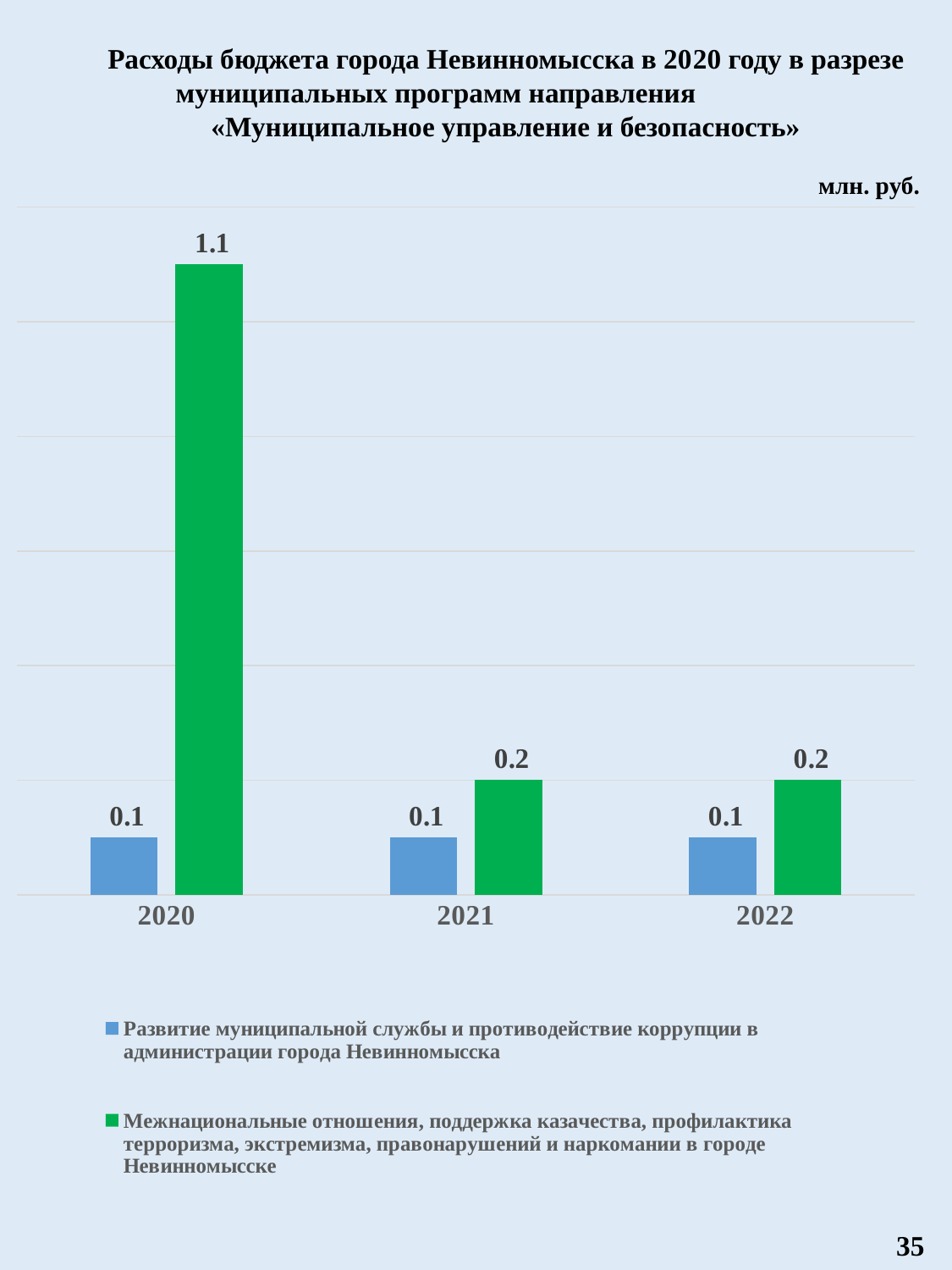
What kind of chart is shown on the slide? Bar chart Does the value for the series «Межнациональные отношения, поддержка казачества...» rise or fall from 2020 to 2021? Fall How many years are shown on the x axis of the chart? 3 What is the value for 2021 for the series «Развитие муниципальной службы и противодействие коррупции в администрации города Невинномысска»? 0.1 What is the value for 2022 for the series «Межнациональные отношения, поддержка казачества, профилактика терроризма, экстремизма, правонарушений и наркомании в городе Невинномысске»? 0.2 What is the difference between the two series' values in 2020? 1.0 What is the difference between the 2020 and 2021 values for the series «Межнациональные отношения, поддержка казачества...»? 0.9 What is the value for 2020 for the series «Межнациональные отношения, поддержка казачества, профилактика терроризма, экстремизма, правонарушений и наркомании в городе Невинномысске»? 1.1 In which year is the value for the series «Межнациональные отношения, поддержка казачества...» the highest? 2020 What unit of measurement is indicated for the chart values? млн. руб. How many series does the legend list? 2 In 2021, which series has the larger value: «Развитие муниципальной службы и противодействие коррупции...» or «Межнациональные отношения, поддержка казачества...»? Межнациональные отношения, поддержка казачества, профилактика терроризма, экстремизма, правонарушений и наркомании в городе Невинномысске